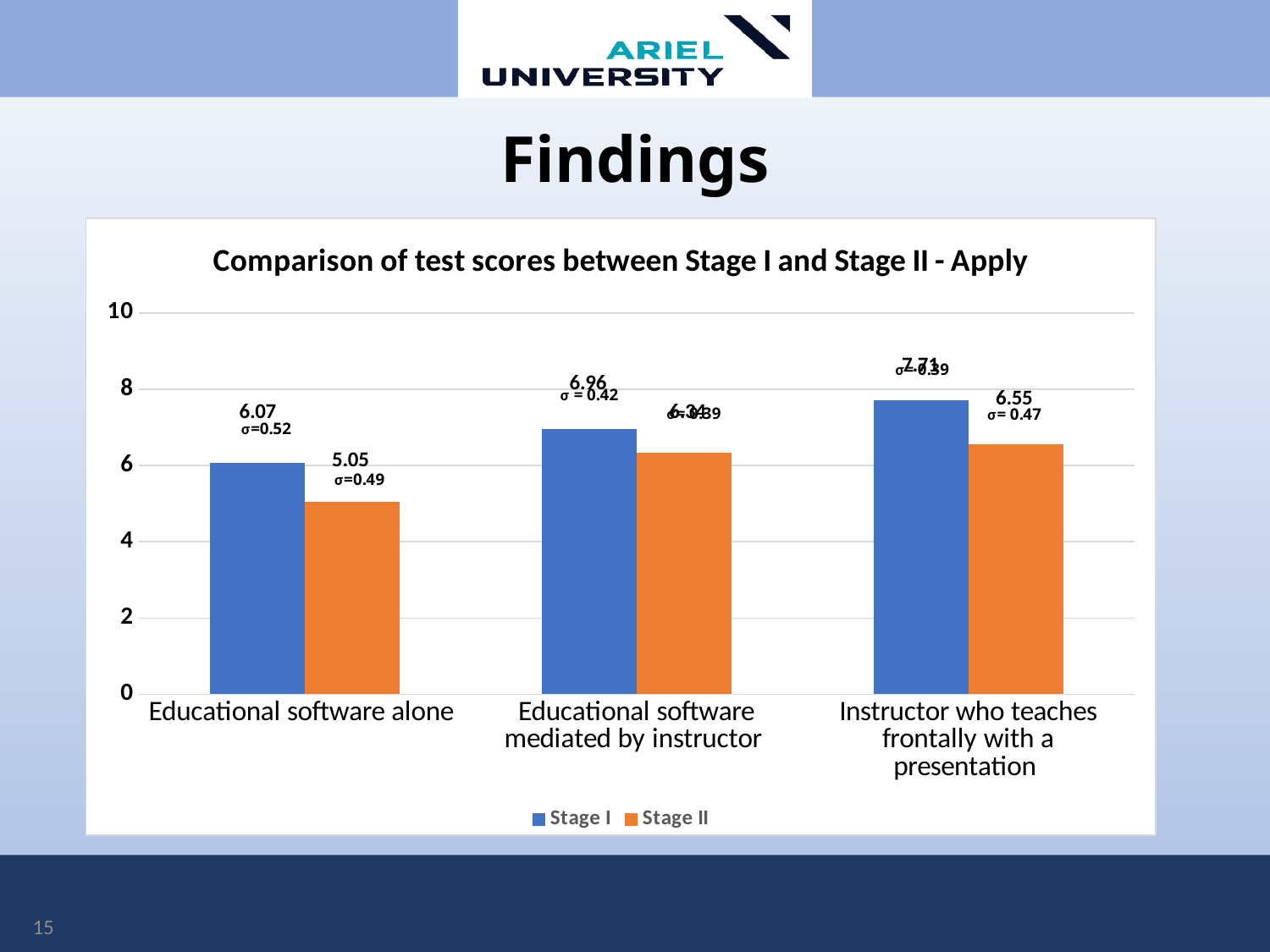
What is the Stage II test score for Instructor who teaches frontally with a presentation? 6.55 Which category has the highest Stage I score? Instructor who teaches frontally with a presentation Which category has the lowest Stage II score? Educational software alone Is the Stage I value for Instructor who teaches frontally with a presentation greater or less than 6? greater What is the Stage I test score for Educational software mediated by instructor? 6.96 How many categories are shown on the x axis? 3 What is the difference between the Stage I and Stage II scores for Educational software alone? 1.02 What is the Stage I test score for Educational software alone? 6.07 What is the Stage II test score for Educational software alone? 5.05 What type of chart is shown on the slide? bar chart For Instructor who teaches frontally with a presentation, which is larger: the Stage I score or the Stage II score? Stage I How many series does the legend list? 2